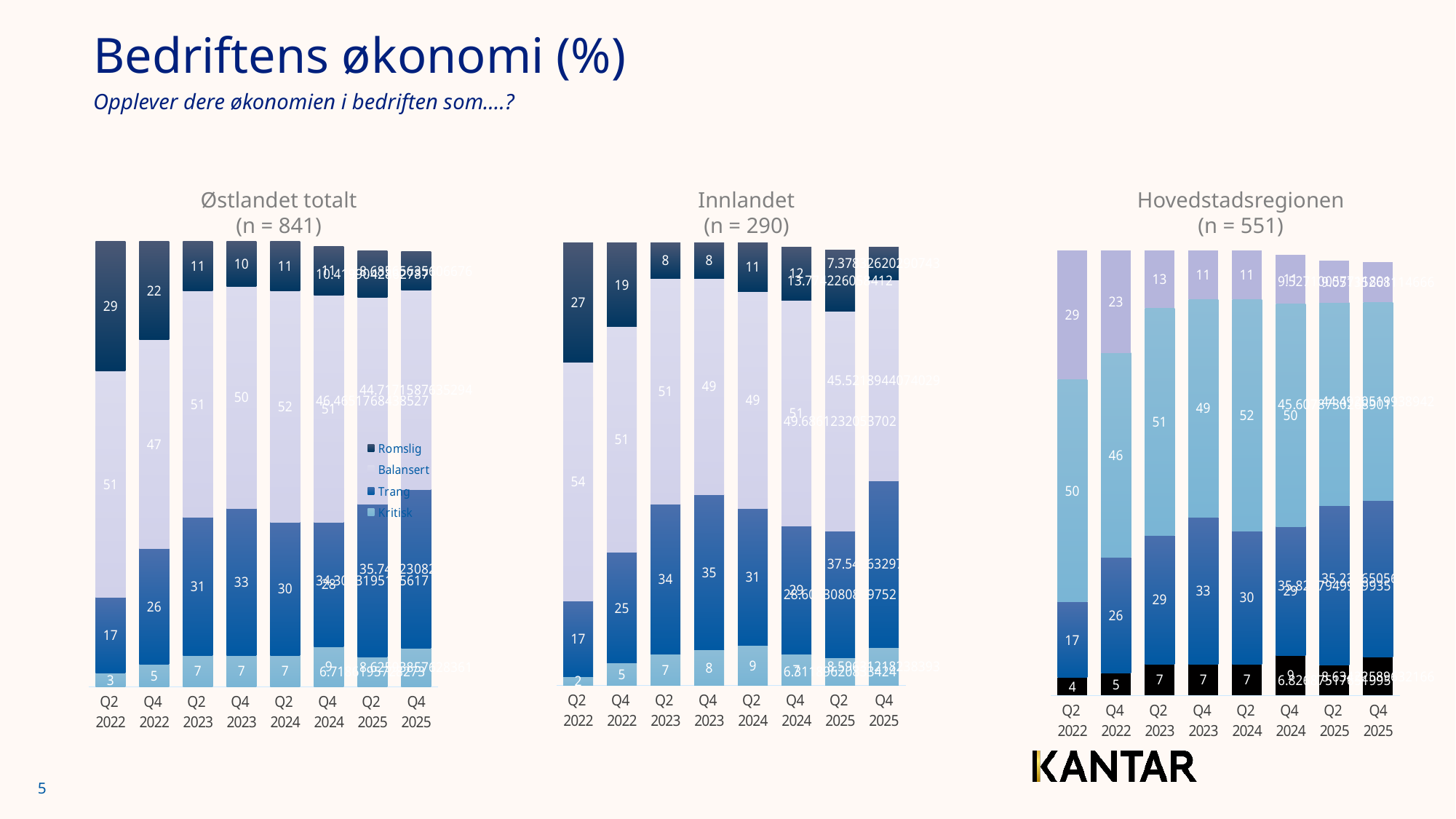
In the "Hovedstadsregionen" chart, what is the Trang value for Q4 2022? 26 How many series does the legend on the "Østlandet totalt" chart list? 4 What is the sample size (n) shown under the title of the "Hovedstadsregionen" chart? 551 In the "Østlandet totalt" chart, which quarter has the highest Romslig value? Q2 2022 In the "Innlandet" chart, which is larger: the Trang value for Q2 2022 or for Q4 2022? Q4 2022 In the "Innlandet" chart, which quarter has the lowest Kritisk value? Q2 2022 In the "Østlandet totalt" chart, what is the Romslig value for Q2 2022? 29 In the "Innlandet" chart, what is the Balansert value for Q2 2022? 54 In the "Østlandet totalt" chart, what is the total of the Q2 2022 stacked bar? 100 What kind of chart is the "Østlandet totalt" chart? Stacked bar chart In the "Østlandet totalt" chart, what is the difference between the Balansert and Trang values for Q2 2022? 34 How many quarters are shown on the x axis of the "Innlandet" chart? 8